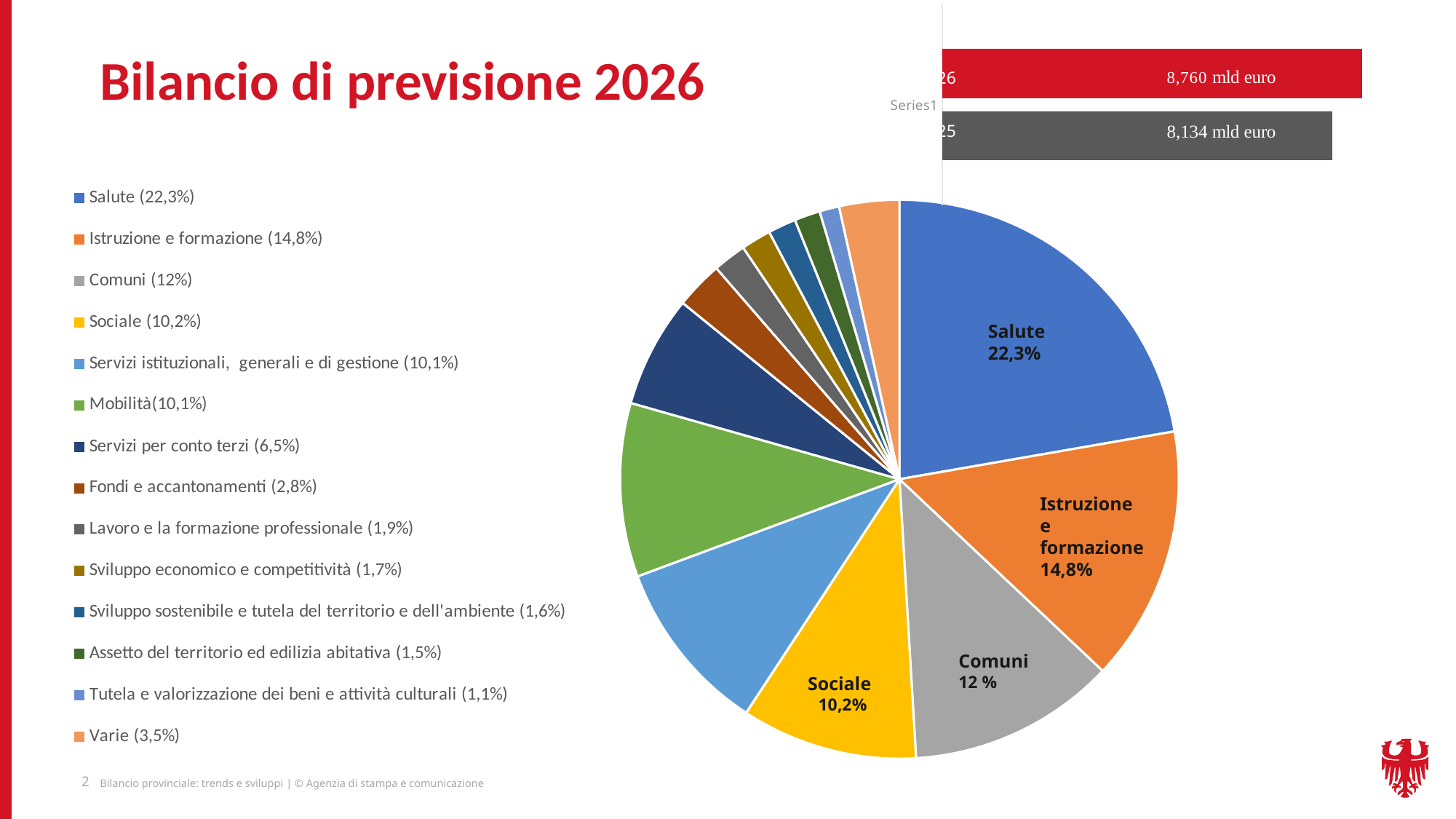
How many categories does the pie chart's legend list? 14 In the pie chart, what share does Salute have? 22,3% In the bar chart at the top right, what value is shown on the red (top) bar? 8,760 mld euro In the pie chart, which category has the smallest share? Tutela e valorizzazione dei beni e attività culturali In the pie chart, which is larger, Comuni or Sociale? Comuni In the pie chart, what share does Istruzione e formazione have? 14,8% In the pie chart, what is the difference between the shares of Salute and Istruzione e formazione? 7,5% What kind of chart is the large chart on the slide? pie chart In the pie chart, which category has the largest share? Salute In the pie chart, what share does Servizi per conto terzi have? 6,5% What kind of chart is the small chart at the top right of the slide? bar chart In the bar chart at the top right, what is the difference between the red bar (8,760 mld euro) and the grey bar (8,134 mld euro)? 0,626 mld euro